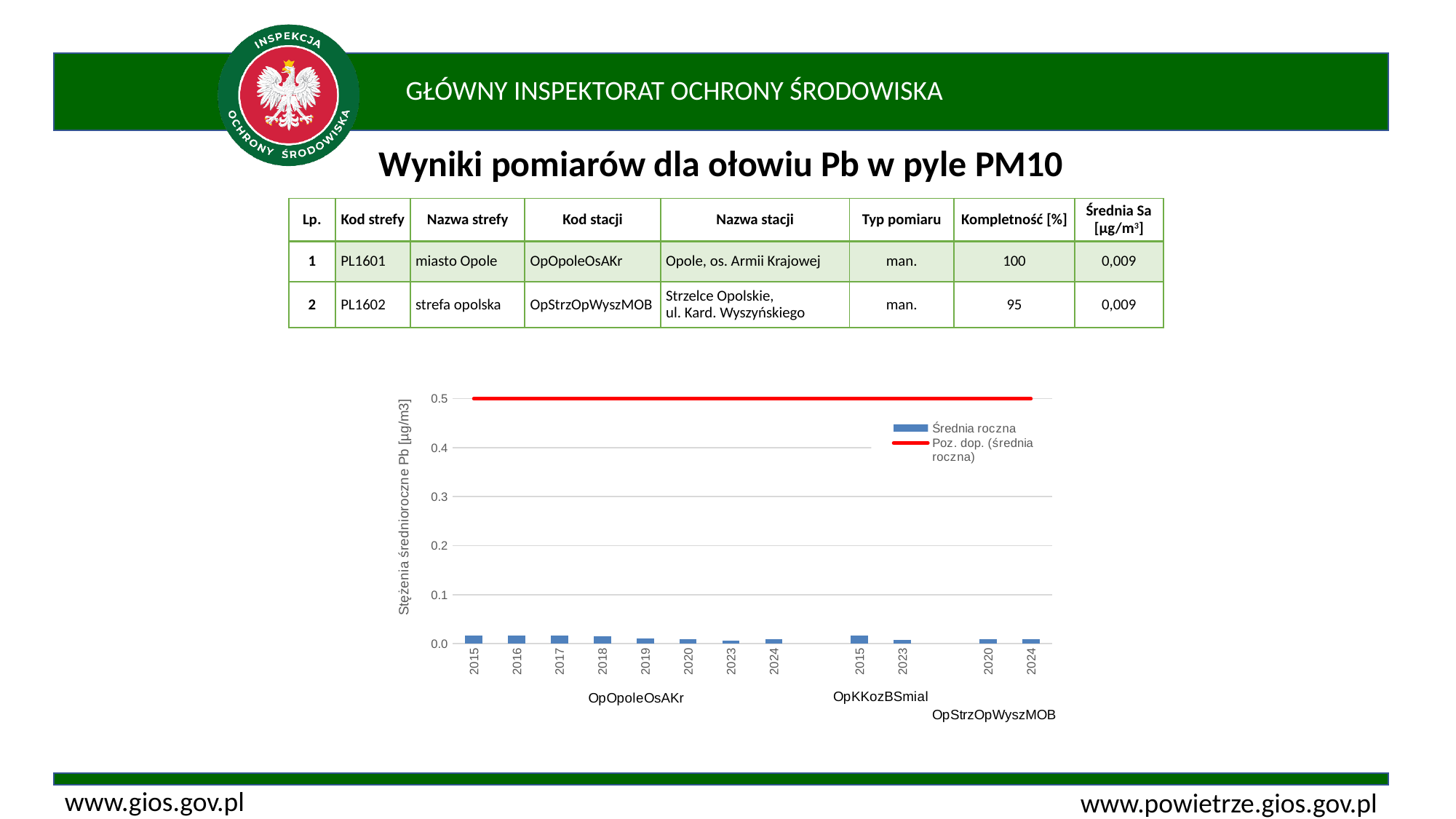
At what value on the y axis is the Poz. dop. (średnia roczna) line drawn? 0.5 Is the Poz. dop. (średnia roczna) line greater or less than 0.4? greater Is the Średnia roczna value for 2024 at OpStrzOpWyszMOB greater or less than 0.1? less How many series does the chart legend list? 2 What is the label of the y axis of the chart? Stężenia średnioroczne Pb [µg/m3] Which legend entry is shown as a red line in the chart? Poz. dop. (średnia roczna) How many years are plotted for station OpOpoleOsAKr in the chart? 8 How many station codes are shown along the x axis of the chart? 3 How many years are plotted for station OpKKozBSmial in the chart? 2 Is the Średnia roczna value for 2015 at OpOpoleOsAKr greater or less than 0.1? less What kind of chart is shown on the slide? combination bar and line chart